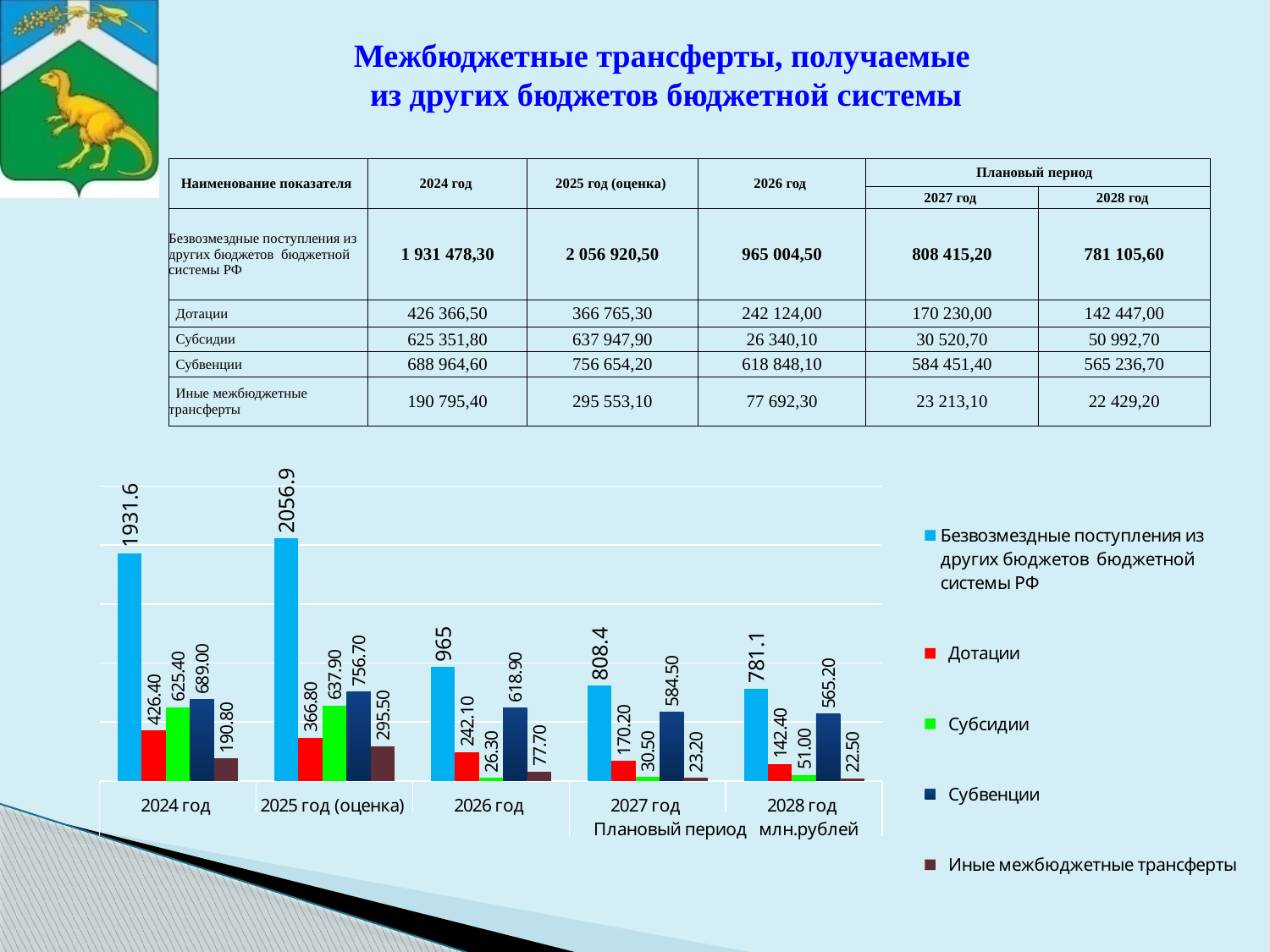
In the chart, which is larger for 2026 год: Дотации or Субвенции? Субвенции In the chart, what is the value of Субвенции for 2027 год? 584.50 In the chart, which year has the lowest value for Субсидии? 2026 год How many year categories are shown along the x axis of the chart? 5 How many series does the chart legend list? 5 In the chart, do the values for Субвенции rise or fall from 2025 год (оценка) to 2028 год? fall In the chart, what is the value of Иные межбюджетные трансферты for 2026 год? 77.70 In the chart, which year has the highest value for Безвозмездные поступления из других бюджетов бюджетной системы РФ? 2025 год (оценка) What colour are the Дотации bars in the chart? red What kind of chart is shown on the slide? bar chart In the chart, what is the difference between the Дотации values for 2024 год and 2028 год? 284.00 In the chart, what is the value of Безвозмездные поступления из других бюджетов бюджетной системы РФ for 2025 год (оценка)? 2056.9